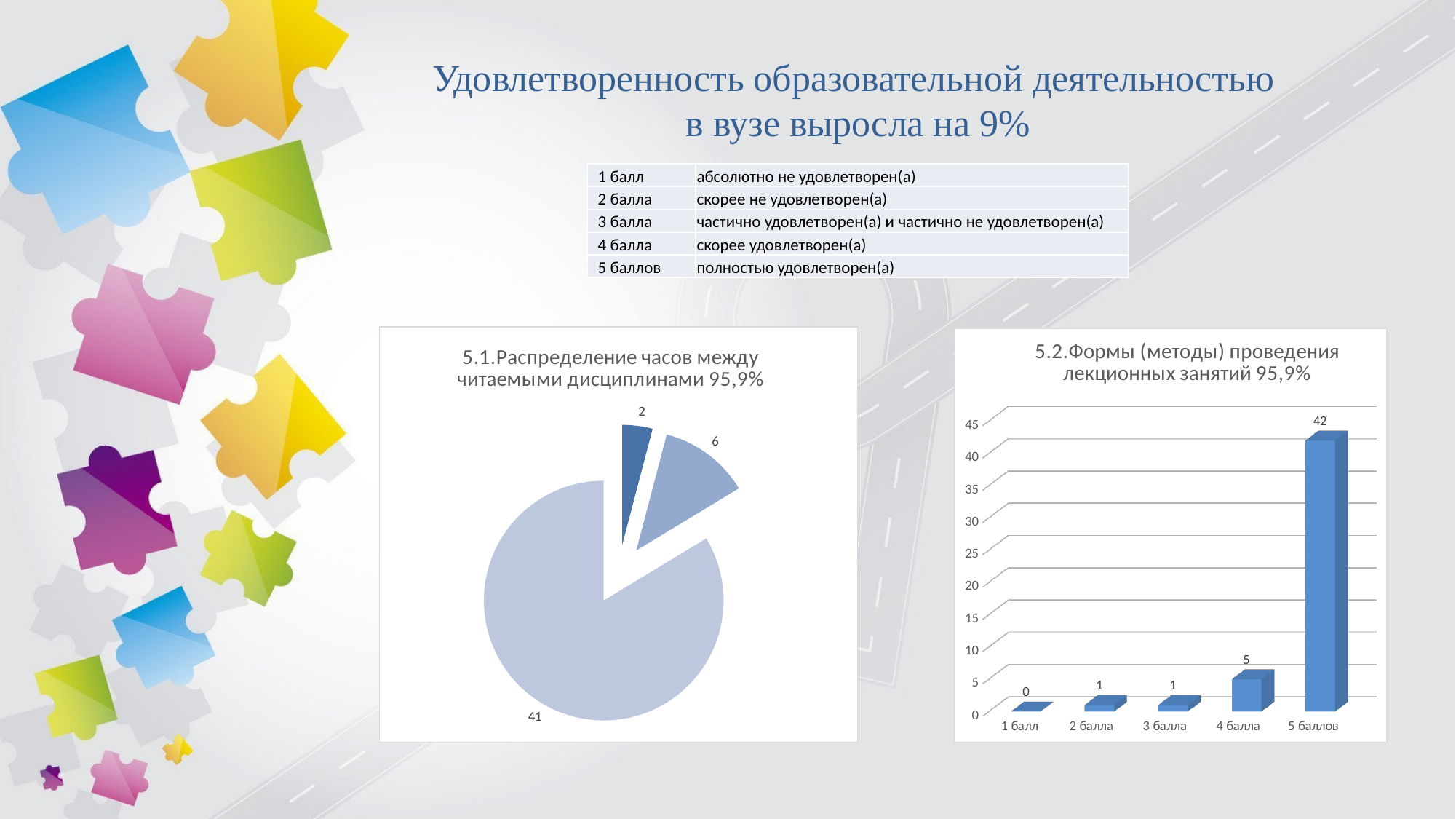
In the chart titled "5.2.Формы (методы) проведения лекционных занятий 95,9%", which category has the lowest value? 1 балл In the pie chart titled "5.1.Распределение часов между читаемыми дисциплинами 95,9%", what is the value of the largest slice? 41 In the chart titled "5.2.Формы (методы) проведения лекционных занятий 95,9%", what is the value for 5 баллов? 42 In the chart titled "5.2.Формы (методы) проведения лекционных занятий 95,9%", how many categories are shown on the x axis? 5 What kind of chart is the one titled "5.2.Формы (методы) проведения лекционных занятий 95,9%"? bar chart In the chart titled "5.2.Формы (методы) проведения лекционных занятий 95,9%", what is the value for 1 балл? 0 In the chart titled "5.2.Формы (методы) проведения лекционных занятий 95,9%", what is the value for 4 балла? 5 In the chart titled "5.2.Формы (методы) проведения лекционных занятий 95,9%", which category has the highest value? 5 баллов In the chart titled "5.2.Формы (методы) проведения лекционных занятий 95,9%", do the values generally rise or fall from 1 балл to 5 баллов? rise In the chart titled "5.2.Формы (методы) проведения лекционных занятий 95,9%", which is larger: the value for 4 балла or the value for 2 балла? 4 балла In the chart titled "5.2.Формы (методы) проведения лекционных занятий 95,9%", what is the difference between the values for 5 баллов and 4 балла? 37 What kind of chart is the one titled "5.1.Распределение часов между читаемыми дисциплинами 95,9%"? pie chart